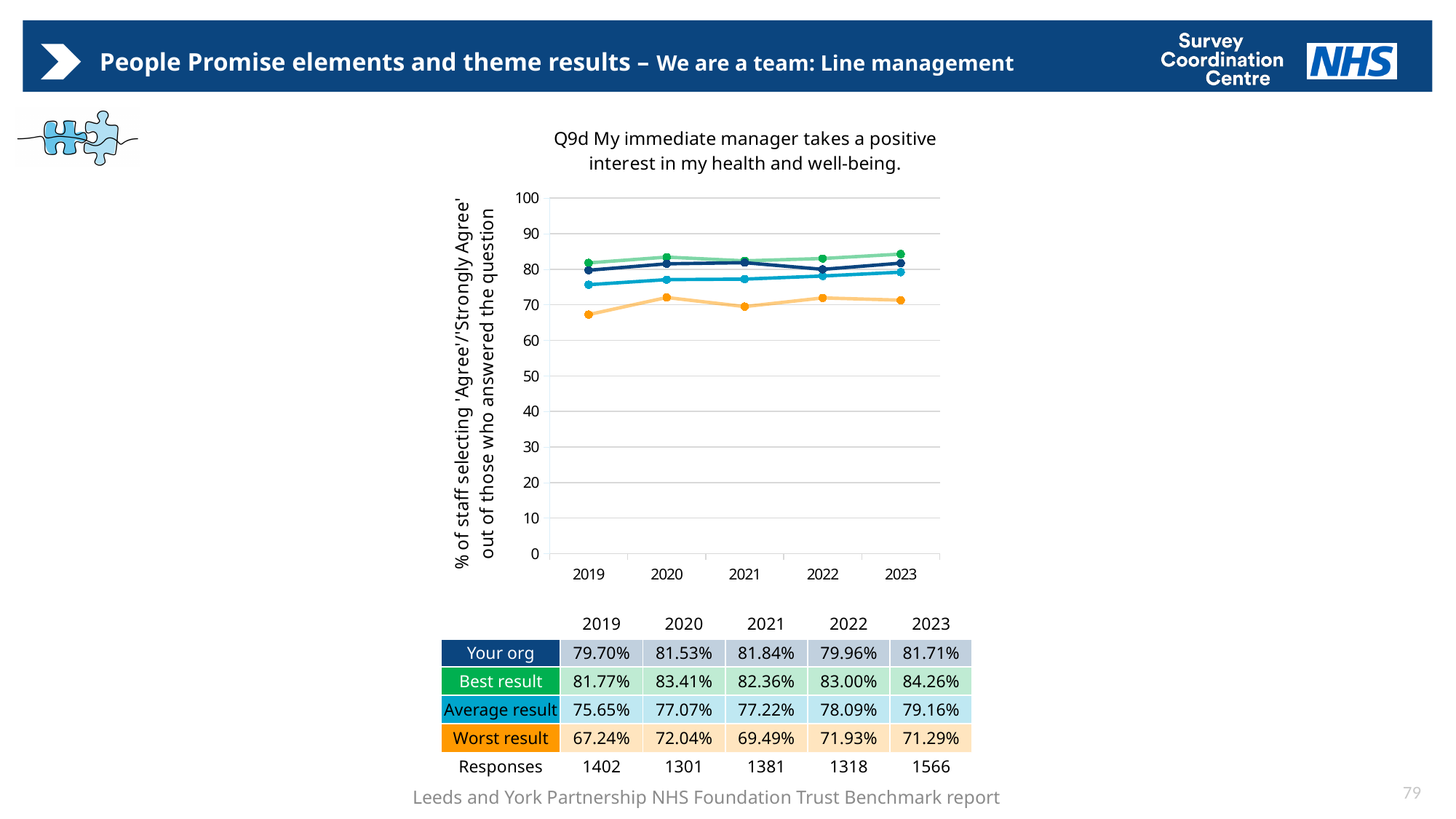
What was the 'Worst result' value in 2019? 67.24% How many series are plotted on the chart? 4 What was the 'Your org' value in 2021? 81.84% What type of chart is shown on the slide? line chart What was the 'Best result' value in 2023? 84.26% In which year was the 'Your org' value highest? 2021 How many years are plotted on the x axis? 5 What was the 'Average result' value in 2022? 78.09% Does the 'Average result' series rise or fall from 2019 to 2023? rise What is the difference between the 'Best result' and 'Your org' values in 2023? 2.55% In which year was the 'Worst result' value lowest? 2019 Which is larger in 2020: the 'Your org' value or the 'Average result' value? Your org